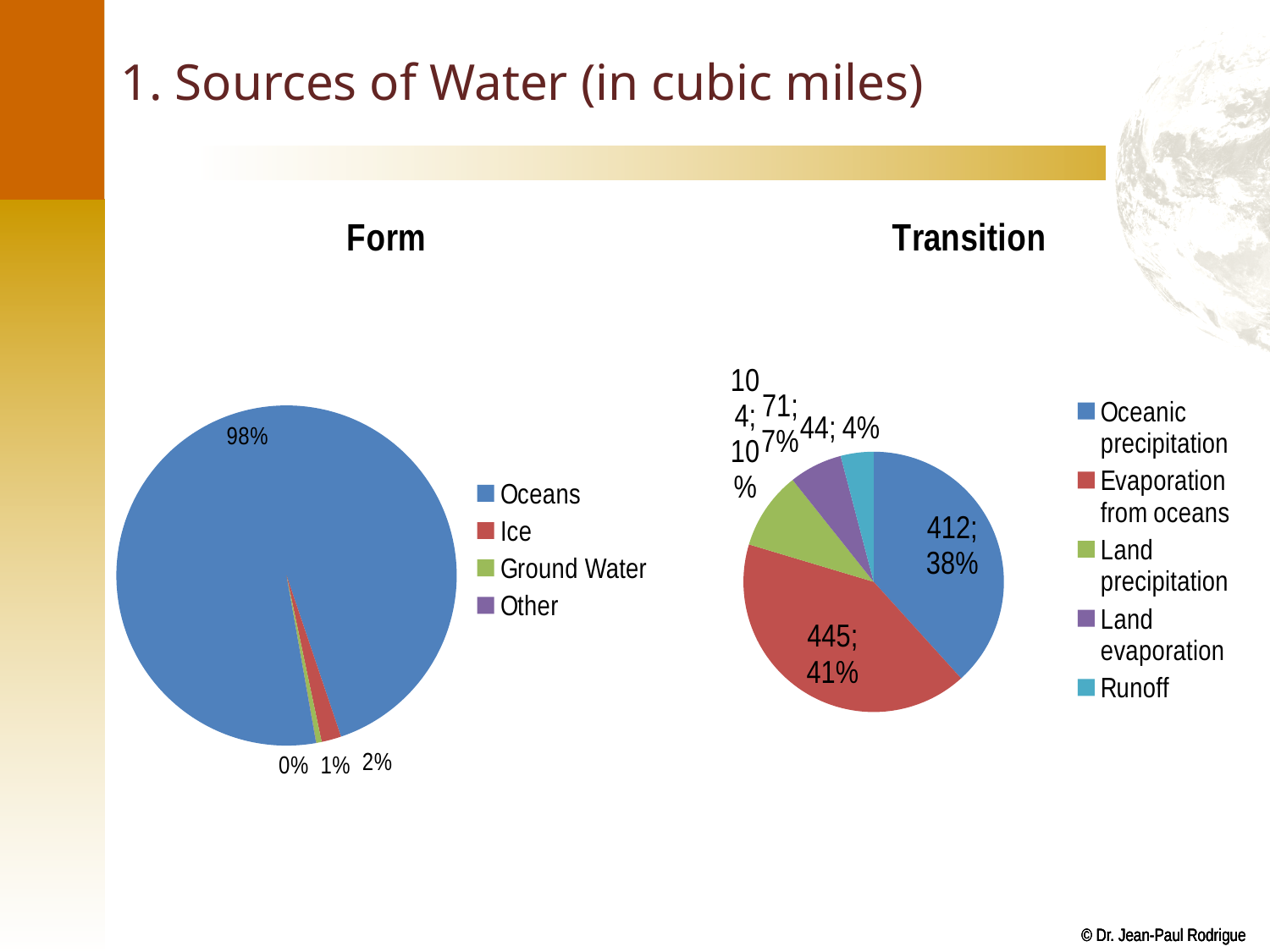
In the Transition pie chart, what share of the pie is Oceanic precipitation? 38% What kind of chart is the Form chart? Pie chart How many categories does the legend of the Transition chart list? 5 In the Transition pie chart, which is larger: Land evaporation or Runoff? Land evaporation In the Transition pie chart, which category has the largest slice? Evaporation from oceans In the Transition pie chart, what is the value for Runoff? 44 In the Form pie chart, what share of the pie is Ice? 2% In the Form pie chart, what share of the pie is Oceans? 98% In the Transition pie chart, what is the difference between the values for Evaporation from oceans and Oceanic precipitation? 33 In the Transition pie chart, what is the value for Evaporation from oceans? 445 How many categories does the legend of the Form chart list? 4 In the Transition pie chart, which category has the smallest slice? Runoff